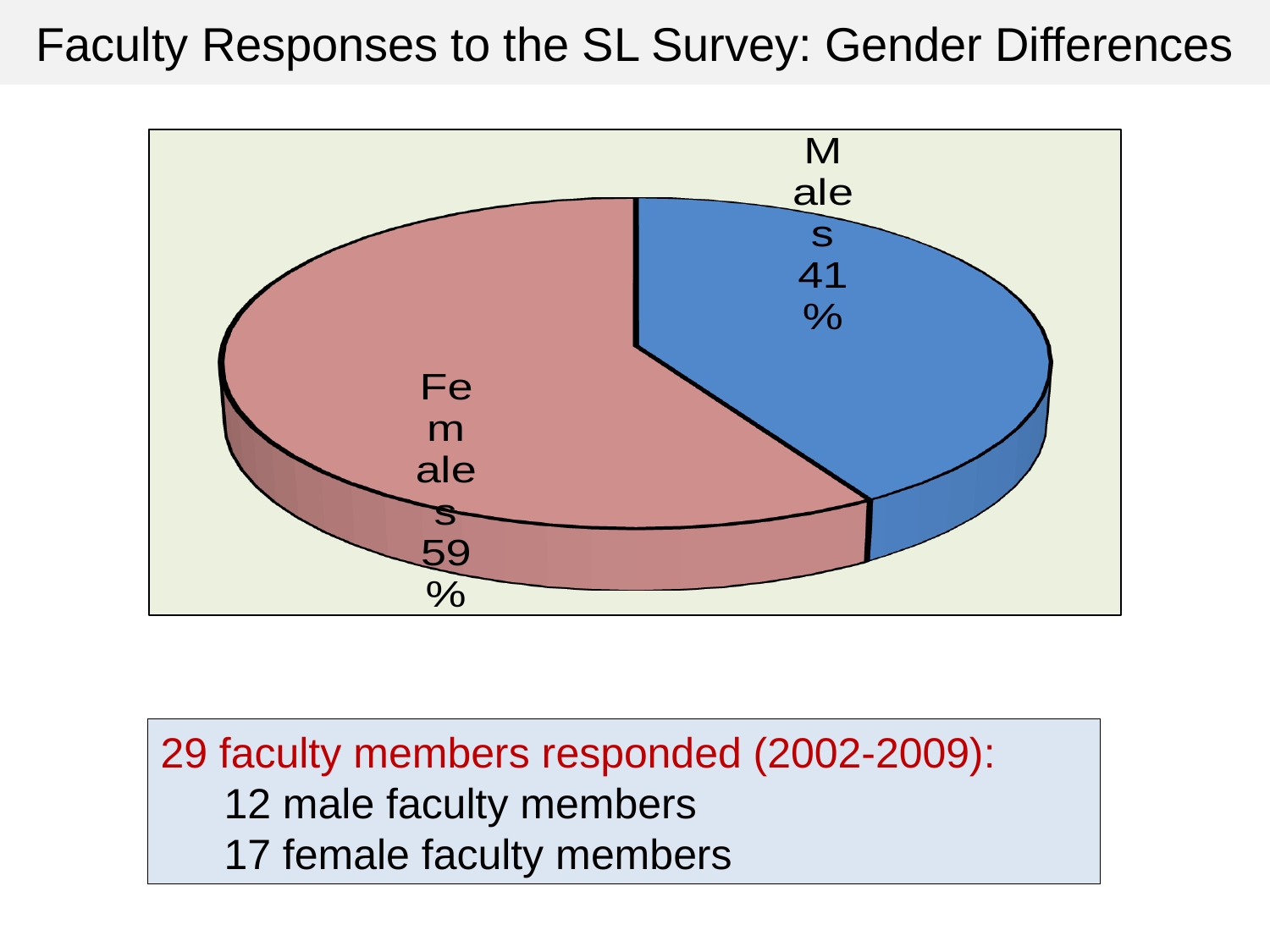
Which slice of the pie is the largest? Females What colour is the Males slice of the pie? blue What kind of chart is shown on the slide? pie chart What percentage of the pie is labelled Males? 41% Which slice of the pie is the smallest? Males What percentage of the pie is labelled Females? 59% How many slices does the pie chart have? 2 Is the Males slice greater or less than 50% of the pie? less What is the difference in percentage points between the Females slice and the Males slice? 18 What colour is the Females slice of the pie? pink Which slice is larger, Males or Females? Females